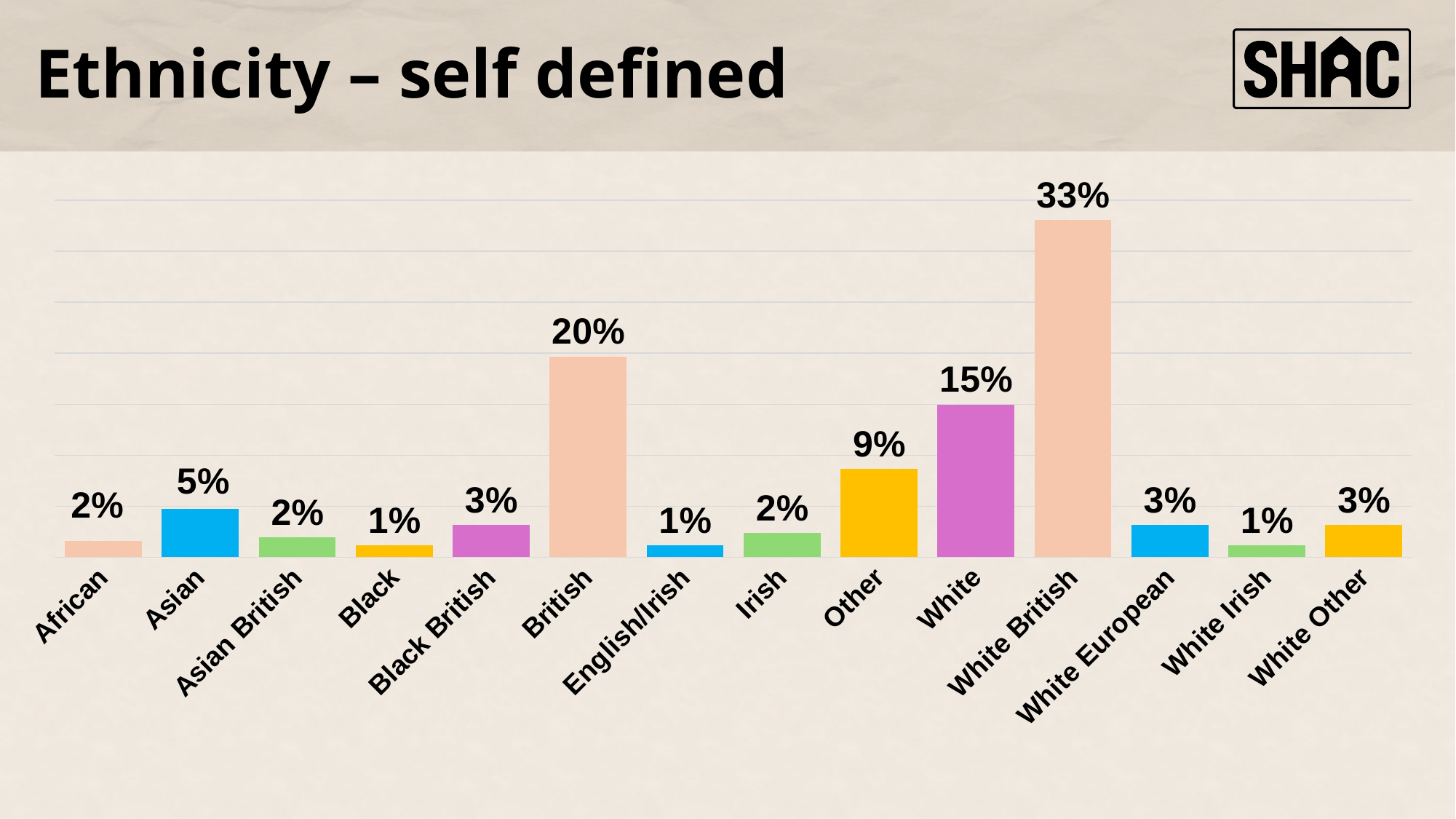
What percentage is shown for Other? 9% How many categories are shown on the x axis? 14 Which is larger, the value for Asian or the value for Black British? Asian What is the value for British? 20% What is the difference between the values for White British and White? 18% What is the value for Asian? 5% What percentage is shown for White British? 33% Which category has the highest value? White British What kind of chart is shown on the slide? Bar chart What is the title of the slide? Ethnicity – self defined What is the difference between the values for British and Other? 11% Which is larger, the value for White or the value for British? British